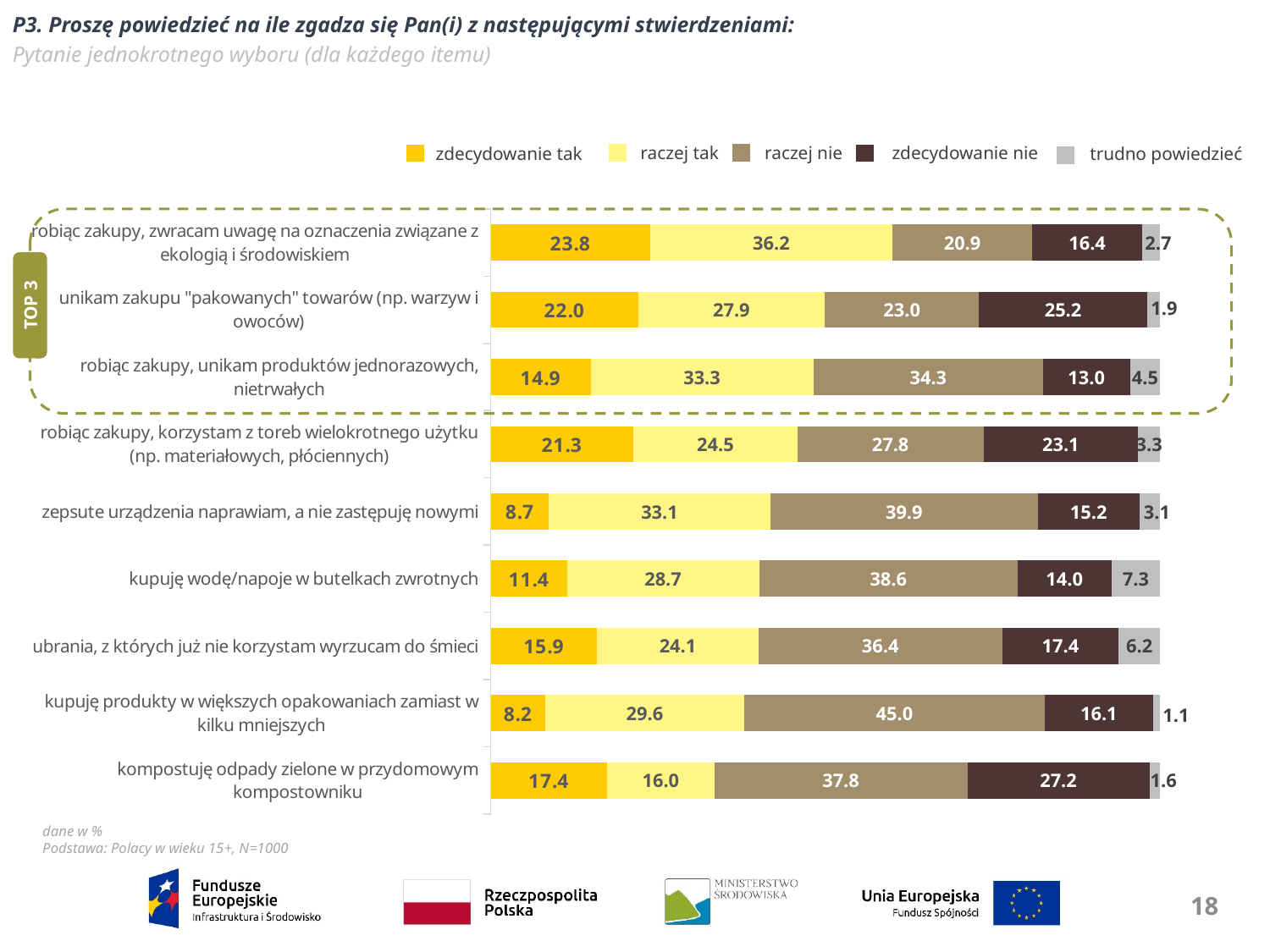
What is the total of the stacked bar for "robiąc zakupy, zwracam uwagę na oznaczenia związane z ekologią i środowiskiem"? 100.0 How many series does the legend list? 5 What is the "trudno powiedzieć" value for "robiąc zakupy, unikam produktów jednorazowych, nietrwałych"? 4.5 Which statement has the lowest "zdecydowanie tak" value? kupuję produkty w większych opakowaniach zamiast w kilku mniejszych What kind of chart is shown on the slide? stacked bar chart What is the difference between the "raczej tak" values for "robiąc zakupy, zwracam uwagę na oznaczenia związane z ekologią i środowiskiem" and "unikam zakupu "pakowanych" towarów"? 8.3 What is the "raczej nie" value for "kupuję produkty w większych opakowaniach zamiast w kilku mniejszych"? 45.0 What is the "zdecydowanie tak" value for "kupuję wodę/napoje w butelkach zwrotnych"? 11.4 Which statement has the highest "zdecydowanie tak" value? robiąc zakupy, zwracam uwagę na oznaczenia związane z ekologią i środowiskiem Which statement has the highest "trudno powiedzieć" value? kupuję wodę/napoje w butelkach zwrotnych Which has the larger "zdecydowanie nie" value: "kompostuję odpady zielone w przydomowym kompostowniku" or "ubrania, z których już nie korzystam wyrzucam do śmieci"? kompostuję odpady zielone w przydomowym kompostowniku How many statements (categories) are plotted in the chart? 9